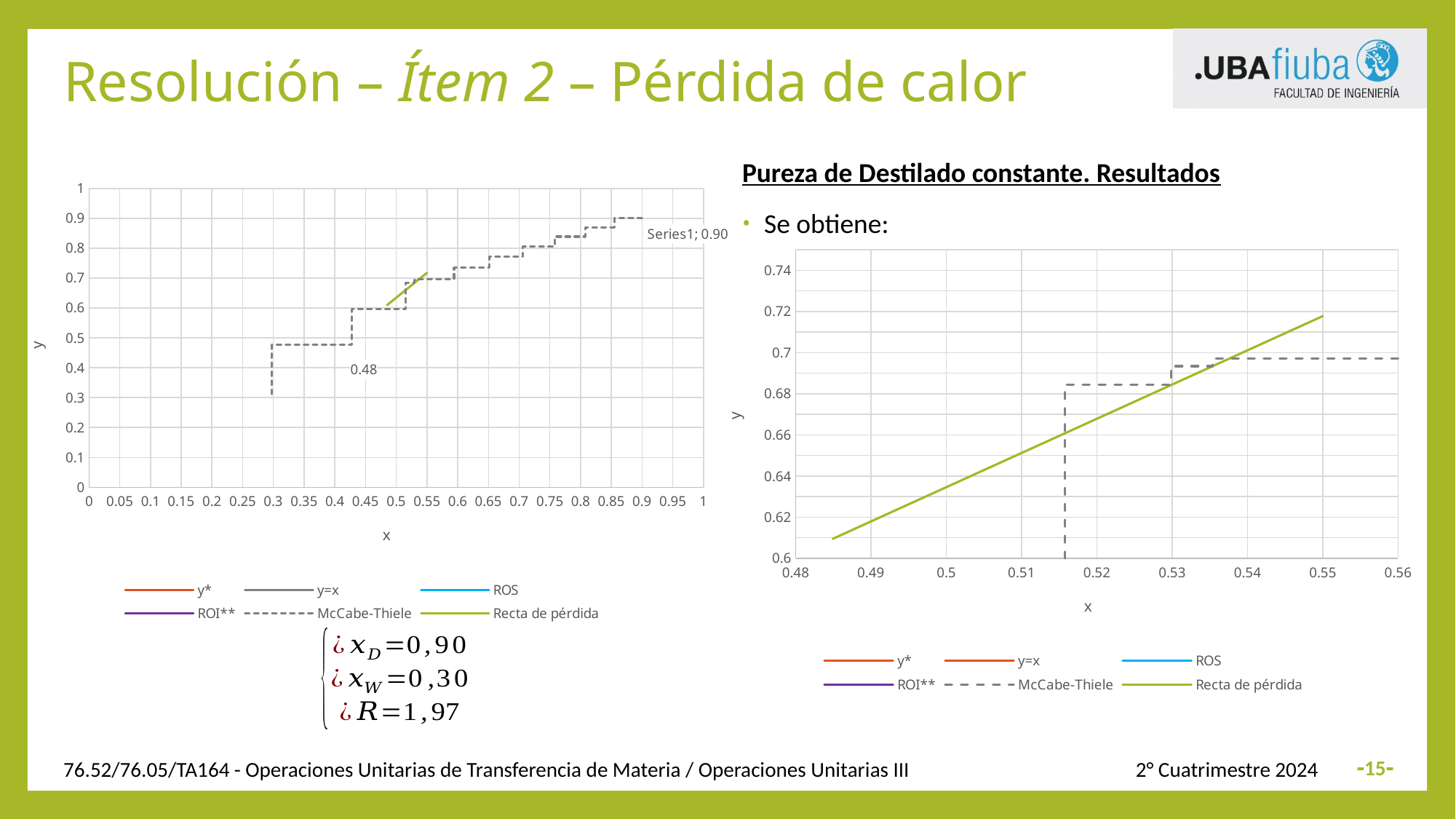
How many series does the legend of the right chart list? 6 In the left chart, what value is printed as a data label below the step near x = 0.4? 0.48 In the right chart, is the McCabe-Thiele horizontal step at x = 0.55 greater or less than 0.7? less In the right chart, is the value of the Recta de pérdida line at x = 0.5 greater or less than 0.62? greater Which legend entry in the left chart is drawn with a dashed line? McCabe-Thiele What is the highest value shown on the x axis of the right chart? 0.56 What kind of chart is the chart on the left of the slide? line chart In the right chart, is the value of the Recta de pérdida line at x = 0.55 greater or less than 0.7? greater How many series does the legend of the left chart list? 6 In the right chart, does the Recta de pérdida line rise or fall as x increases? rises In the left chart, what value is shown by the data label at the top of the McCabe-Thiele staircase? 0.90